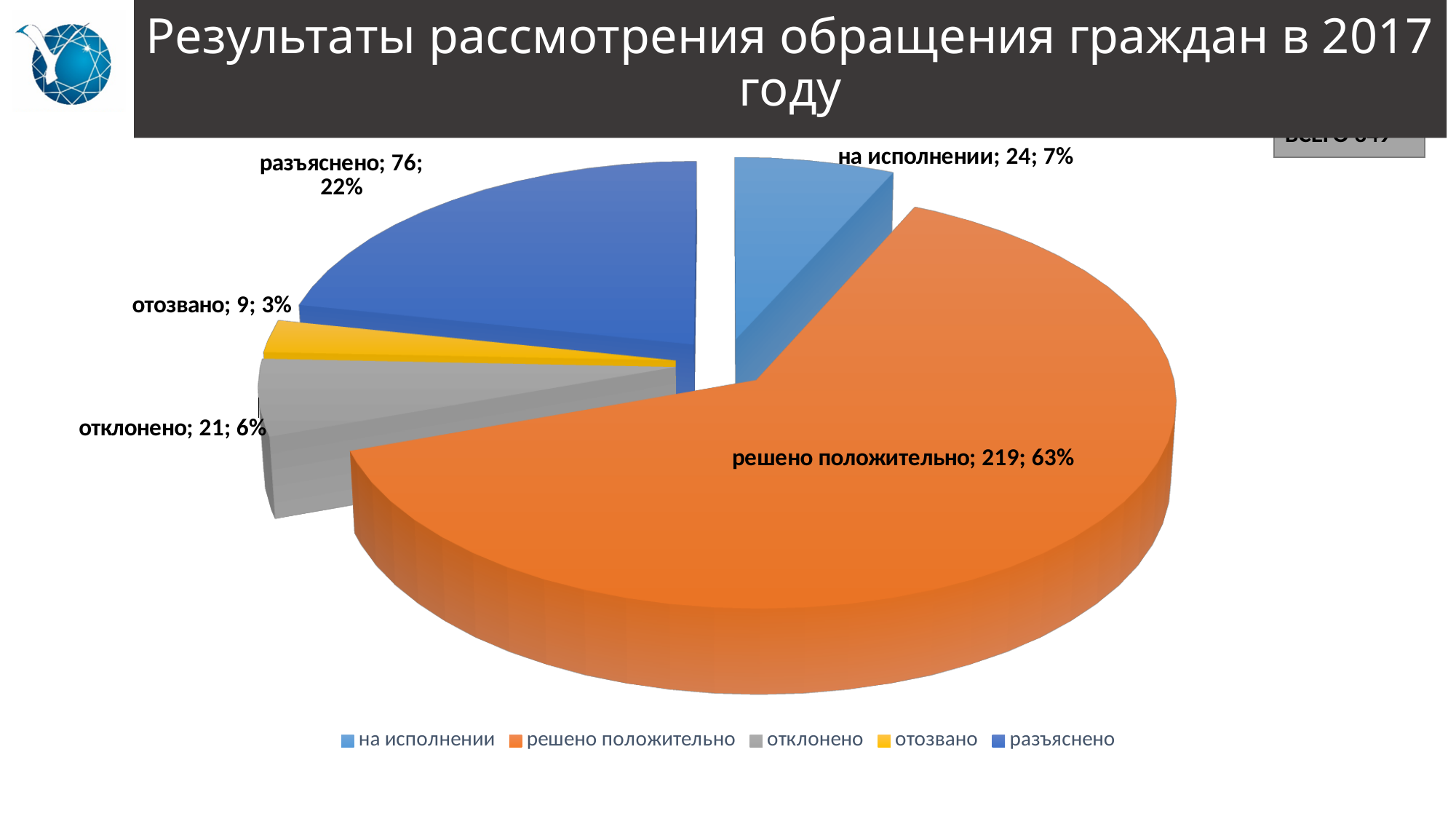
What is the difference between the values for "разъяснено" and "отклонено"? 55 What is the value for "разъяснено"? 76 What is the value for "на исполнении"? 24 What is the value for "отозвано"? 9 Which category has the largest slice? решено положительно How many entries does the legend list? 5 What share of the pie does "отклонено" represent? 6% What kind of chart is shown on the slide? pie chart How many slices does the pie chart have? 5 Which category has the smallest slice? отозвано What is the value for "решено положительно"? 219 Which is larger, the value for "на исполнении" or the value for "отклонено"? на исполнении